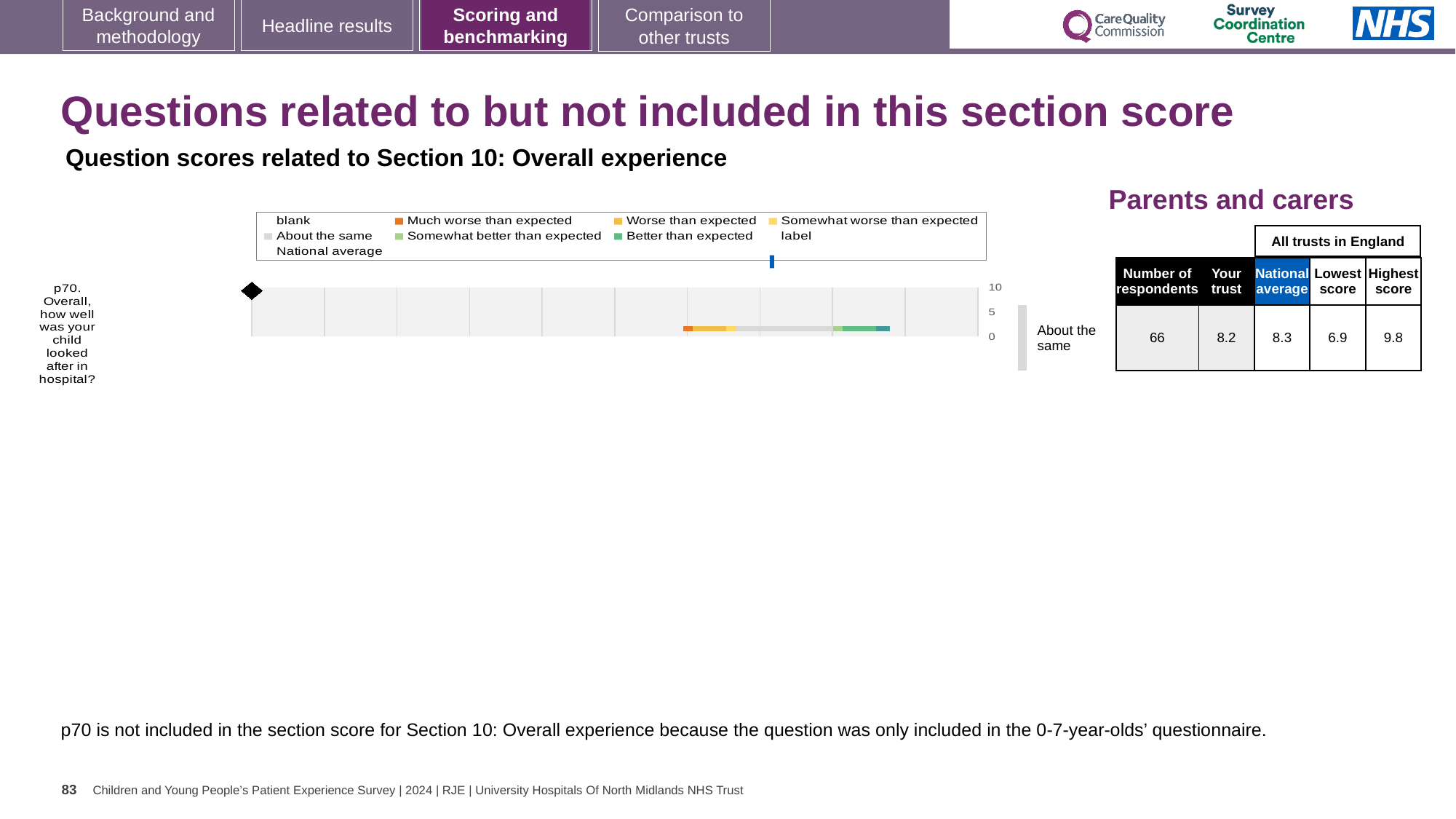
How many questions are plotted in the chart? 1 What is the national average score for p70? 8.3 What is the difference between the highest score and the lowest score for p70? 2.9 How many respondents answered p70? 66 Which question is plotted in the chart? p70. Overall, how well was your child looked after in hospital? What type of chart is used to show the p70 result? bar chart What is the highest score among all trusts in England for p70? 9.8 Which is larger for p70, the 'Your trust' score or the national average? national average Which legend entry is shown in orange? Much worse than expected What is the lowest score among all trusts in England for p70? 6.9 What is the 'Your trust' score for p70 in the Parents and carers table? 8.2 What benchmark category is shown next to the bar for p70? About the same